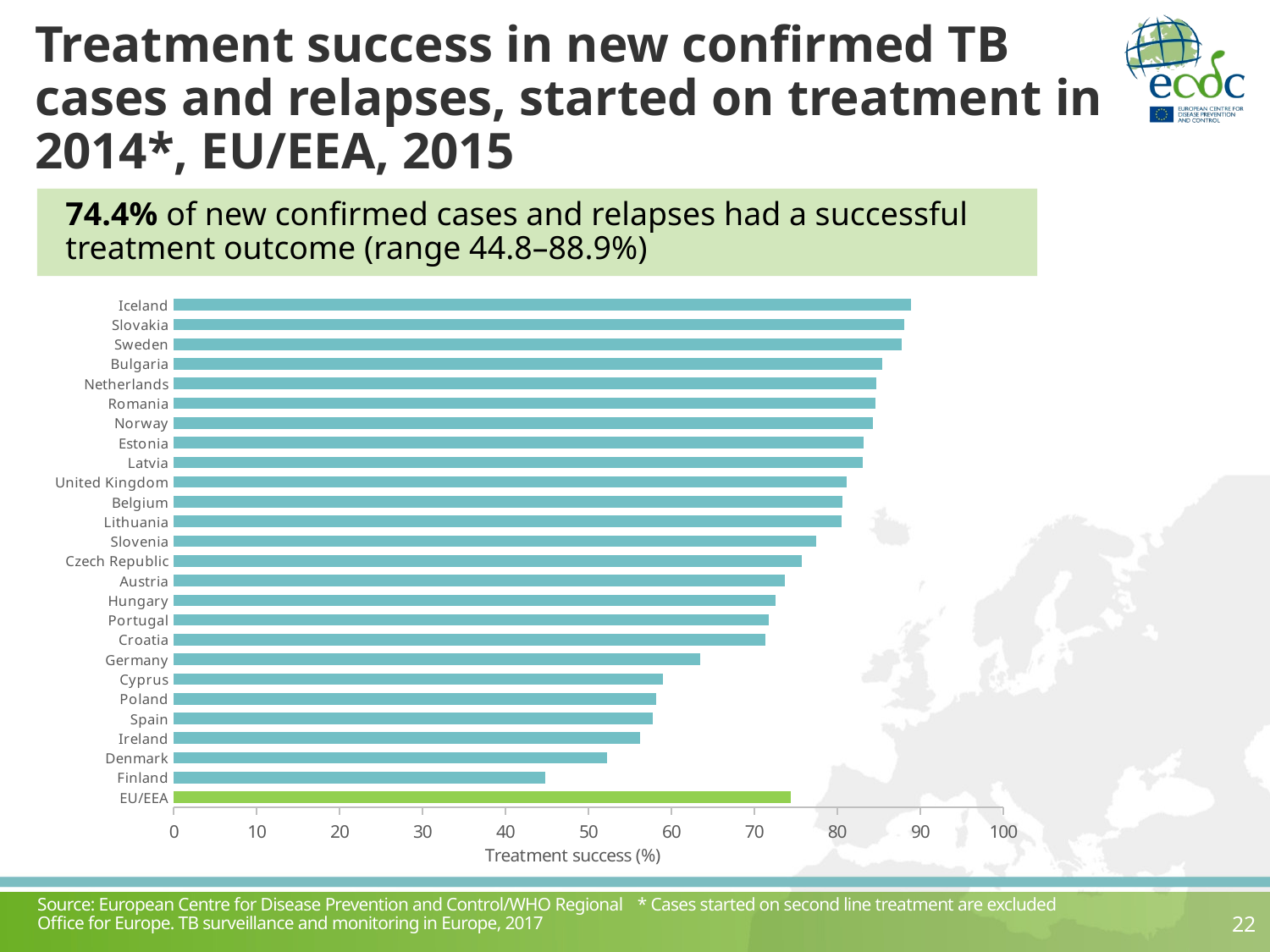
How many bars are plotted in the chart, including EU/EEA? 26 Is the treatment success value for Germany greater or less than 60? greater What is the treatment success value for EU/EEA? 74.4% What is the treatment success value for Iceland, the top of the range? 88.9% Which country has the lowest treatment success in the chart? Finland Is the treatment success value for Slovenia greater or less than 80? less Which country has the highest treatment success in the chart? Iceland What is the label of the horizontal axis? Treatment success (%) Which has a higher treatment success, Sweden or Spain? Sweden What kind of chart is shown on the slide? bar chart What is the treatment success value for Finland, the bottom of the range? 44.8% What is the difference in treatment success between Iceland and Finland? 44.1 percentage points